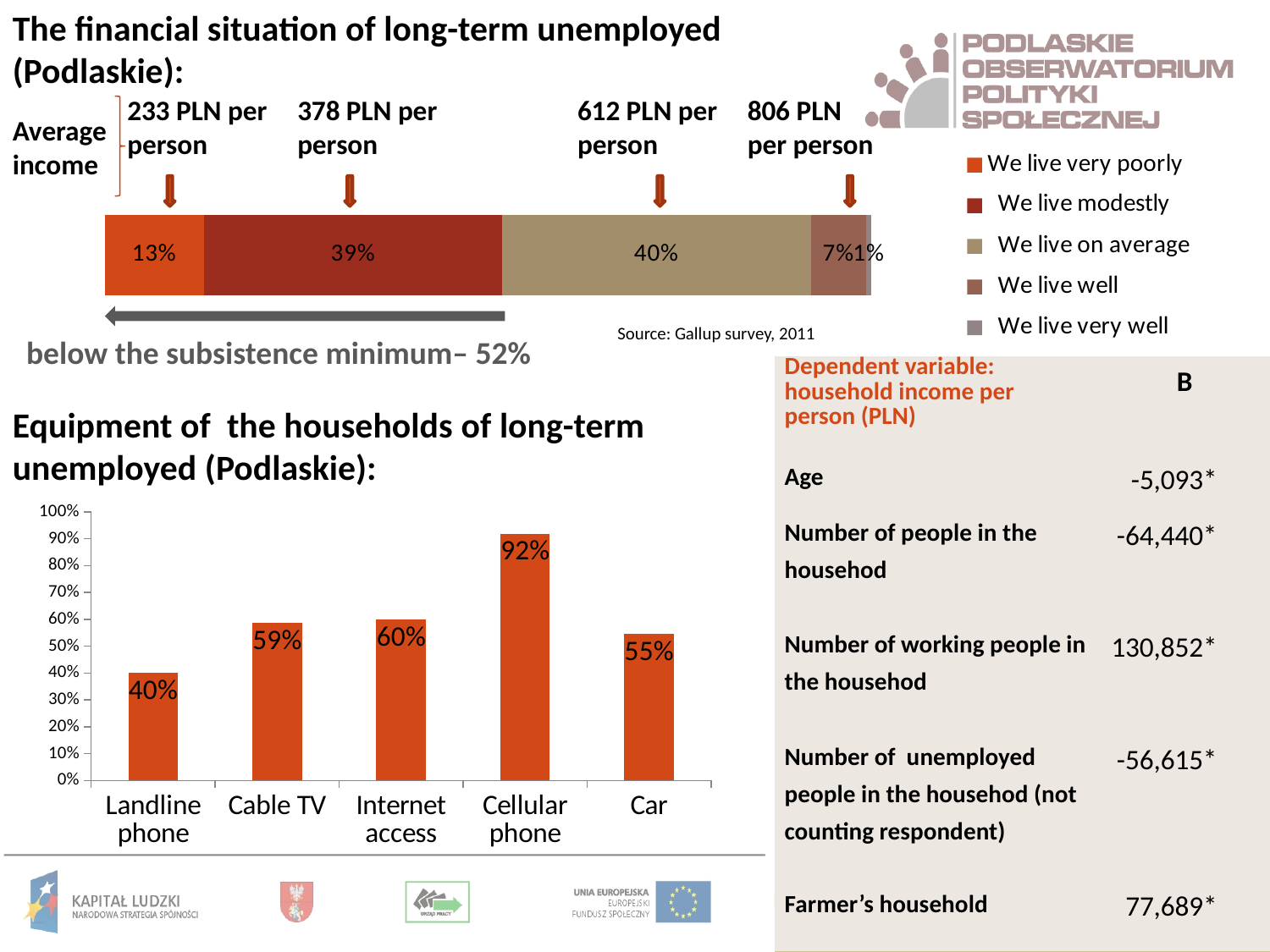
In the 'Equipment of the households of long-term unemployed (Podlaskie)' chart, what is the difference between the values for Cellular phone and Car? 37% In the 'Equipment of the households of long-term unemployed (Podlaskie)' chart, which category has the lowest value? Landline phone In the 'Financial situation of long-term unemployed (Podlaskie)' stacked bar, what share of respondents say 'We live modestly'? 39% In the 'Equipment of the households of long-term unemployed (Podlaskie)' chart, which is larger, the value for Car or the value for Landline phone? Car In the 'Financial situation of long-term unemployed (Podlaskie)' stacked bar, what is the combined share of 'We live very poorly' and 'We live modestly'? 52% What kind of chart is the 'Equipment of the households of long-term unemployed (Podlaskie)' chart? bar chart In the 'Equipment of the households of long-term unemployed (Podlaskie)' chart, which category has the highest value? Cellular phone How many entries does the legend of the 'Financial situation of long-term unemployed (Podlaskie)' chart list? 5 In the 'Equipment of the households of long-term unemployed (Podlaskie)' chart, what is the value for Landline phone? 40% In the 'Equipment of the households of long-term unemployed (Podlaskie)' chart, how many categories are shown? 5 In the 'Equipment of the households of long-term unemployed (Podlaskie)' chart, what is the value for Cellular phone? 92% In the 'Financial situation of long-term unemployed (Podlaskie)' stacked bar, what share of respondents say 'We live very poorly'? 13%